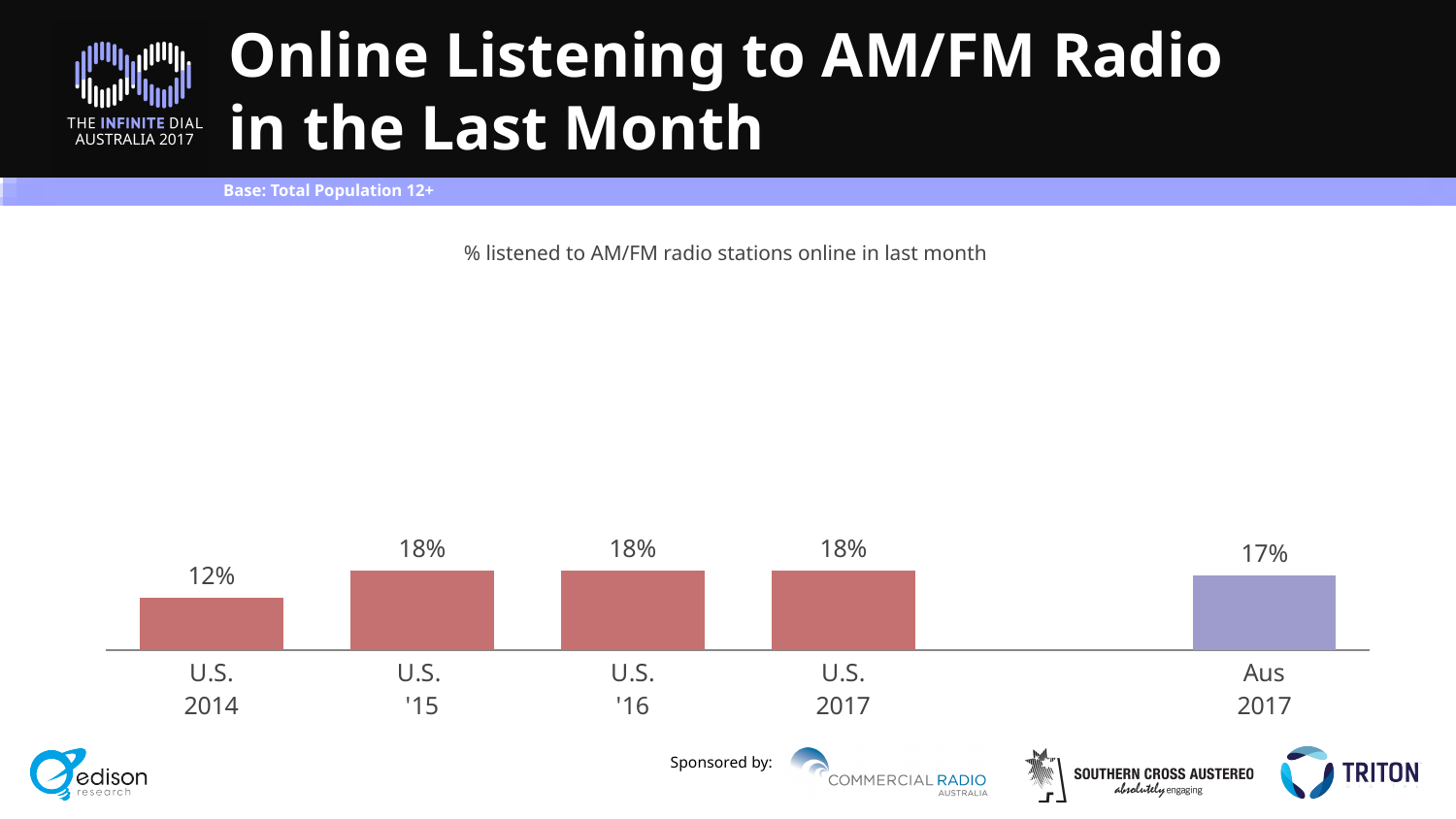
Which category has the lowest value? U.S. 2014 What is the value for U.S. '16? 18% Which is larger, the value for U.S. 2017 or the value for Aus 2017? U.S. 2017 Which is larger, the value for U.S. 2014 or the value for Aus 2017? Aus 2017 What is the difference between the U.S. 2017 value and the Aus 2017 value? 1% What is the difference between the U.S. '15 value and the U.S. 2014 value? 6% What is the value for Aus 2017? 17% How many categories are shown in the chart? 5 Do the U.S. values rise or fall from 2014 to '15? Rise What kind of chart is shown on the slide? Bar chart What is the subtitle text above the chart? % listened to AM/FM radio stations online in last month What is the value for U.S. 2014? 12%